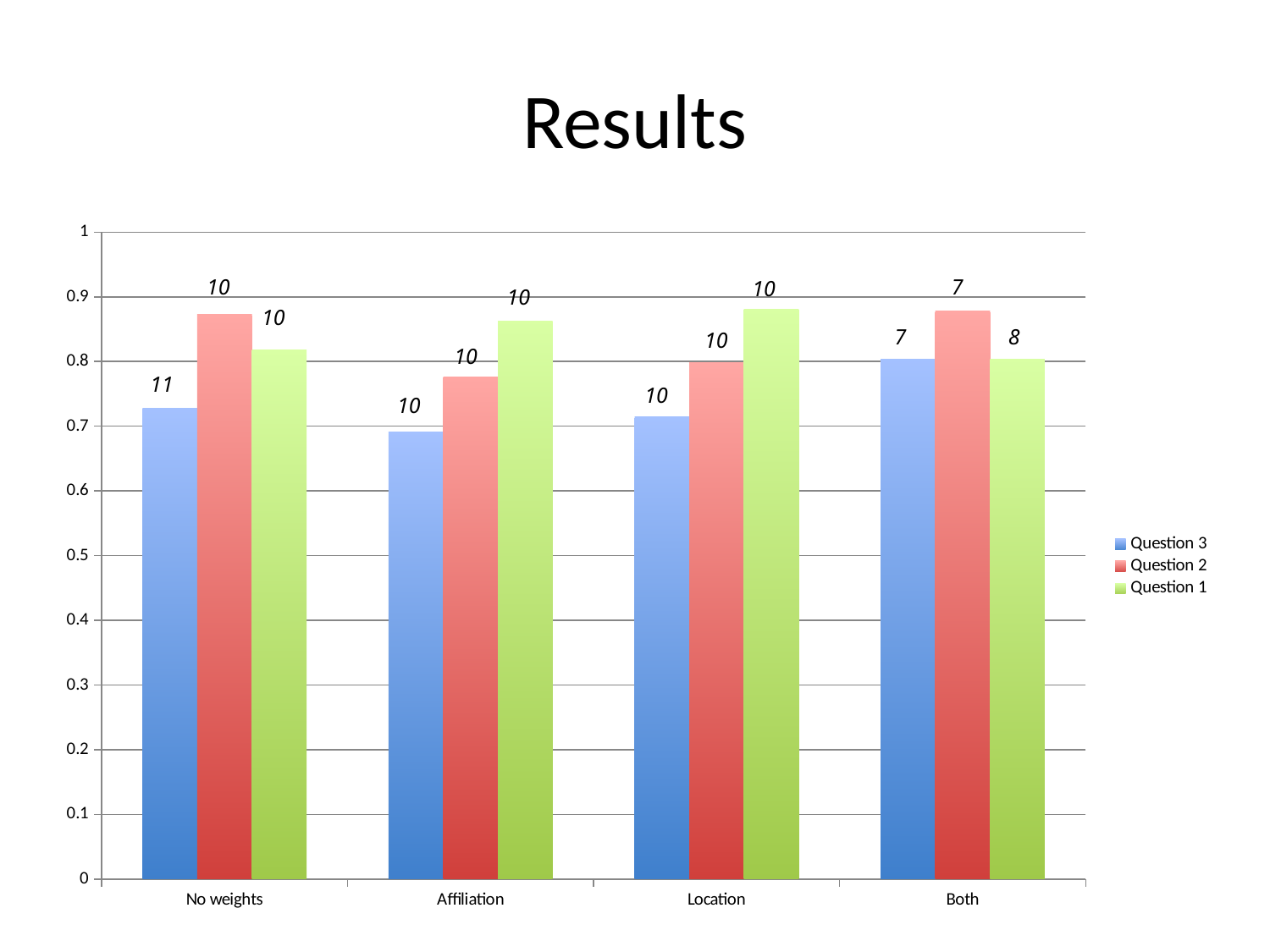
Is the value for Question 3 at Affiliation greater or less than 0.8? less Which series has the highest value in the Affiliation category? Question 1 What is the title of the chart? Results Which category has the highest value for Question 3? Both How many series does the legend list? 3 Is the value for Question 2 at No weights greater or less than 0.8? greater How many categories are shown on the x axis? 4 Which colour represents Question 1 in the legend? green Which series has the highest value in the No weights category? Question 2 Is the value for Question 3 at No weights greater or less than 0.7? greater What kind of chart is shown on the slide? bar chart